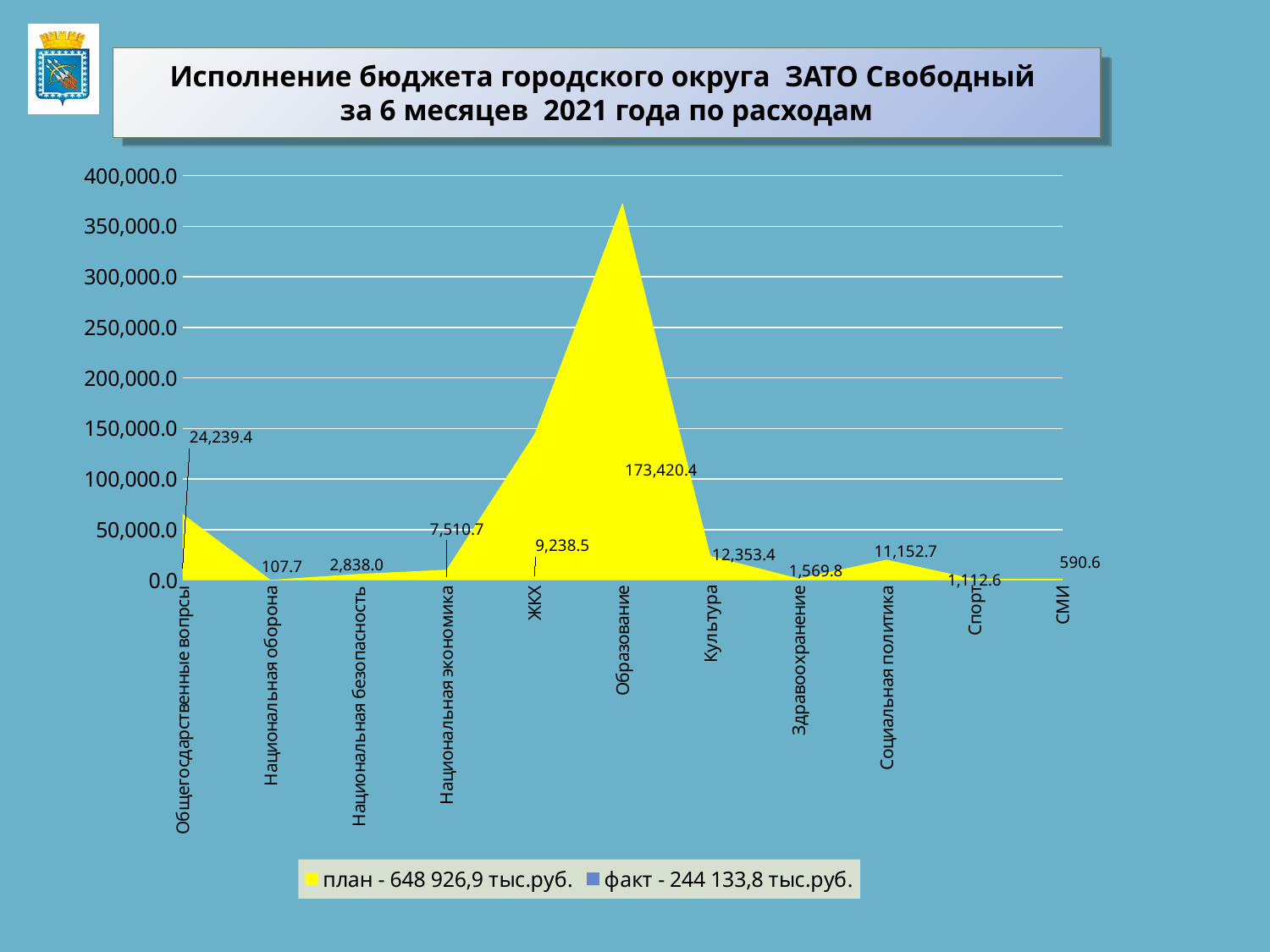
Is the peak of the yellow план area for Образование greater or less than 350,000.0? greater What data label is shown for СМИ? 590.6 How many series does the legend list? 2 Which category has the lowest labelled value on the chart? Национальная оборона What is the difference between the labelled values for Культура and Социальная политика? 1,200.7 Which has the larger labelled value, ЖКХ or Национальная экономика? ЖКХ What kind of chart is shown on the slide? Area chart What data label is shown for Социальная политика? 11,152.7 How many expenditure categories are shown along the x axis? 11 What data label is shown for Образование on the chart? 173,420.4 What data label is shown for Общегосударственные вопросы? 24,239.4 Which category has the highest labelled value on the chart? Образование